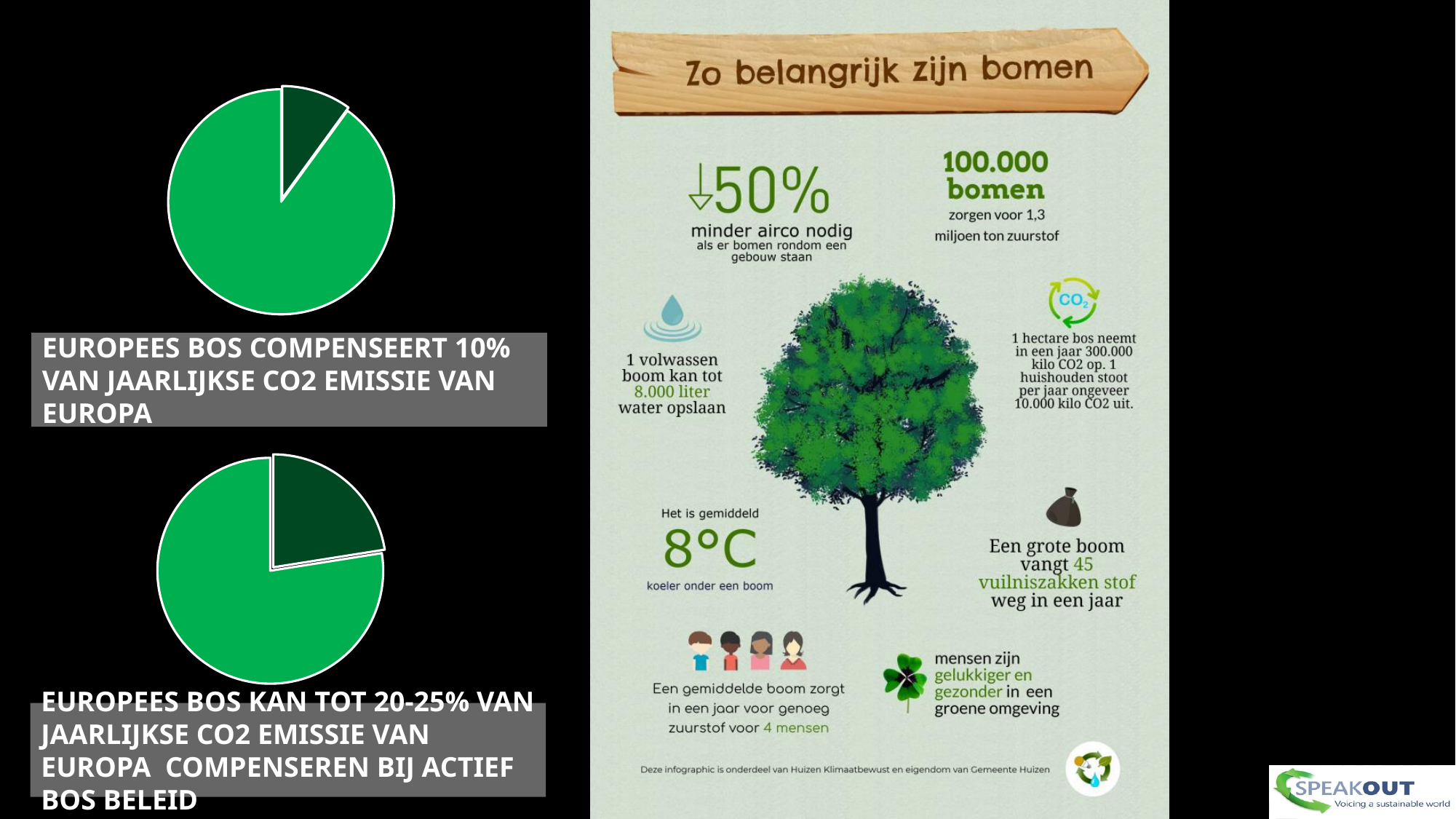
What colour is the smaller slice in the top pie chart? dark green How many charts are shown on the left side of the slide? 2 Is the dark green slice larger in the top pie chart or in the bottom pie chart? the bottom pie chart How many slices does the top pie chart have? 2 In the top pie chart, which slice is larger, the dark green one or the light green one? the light green one What caption is written under the top pie chart? EUROPEES BOS COMPENSEERT 10% VAN JAARLIJKSE CO2 EMISSIE VAN EUROPA In the bottom pie chart, which slice is larger, the dark green one or the light green one? the light green one How many slices does the bottom pie chart have? 2 What kind of chart is the bottom chart on the left of the slide? pie chart What kind of chart is the top chart on the left of the slide? pie chart